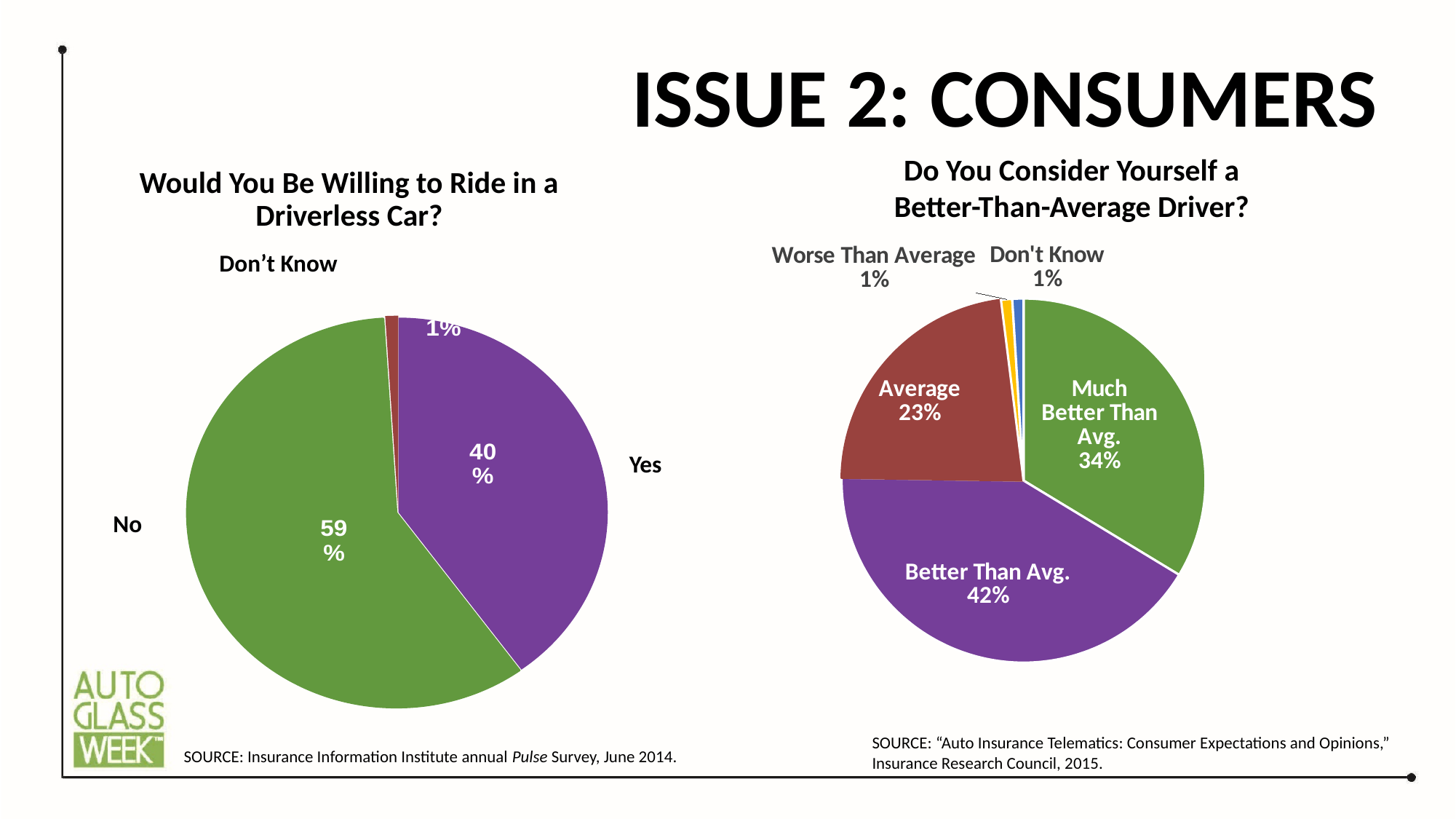
In the 'Would You Be Willing to Ride in a Driverless Car?' chart, which response has the largest share? No In the 'Would You Be Willing to Ride in a Driverless Car?' chart, what is the difference between the No and Yes shares? 19% In the 'Do You Consider Yourself a Better-Than-Average Driver?' chart, which response has the largest share? Better Than Avg. In the 'Would You Be Willing to Ride in a Driverless Car?' chart, which response has the smallest share? Don't Know In the 'Do You Consider Yourself a Better-Than-Average Driver?' chart, which is larger: Much Better Than Avg. or Average? Much Better Than Avg. In the 'Do You Consider Yourself a Better-Than-Average Driver?' chart, how many categories are shown? 5 In the 'Do You Consider Yourself a Better-Than-Average Driver?' chart, what percentage answered Average? 23% What type of chart is used for 'Would You Be Willing to Ride in a Driverless Car?' Pie chart In the 'Do You Consider Yourself a Better-Than-Average Driver?' chart, what percentage answered Better Than Avg.? 42% In the 'Do You Consider Yourself a Better-Than-Average Driver?' chart, what is the difference between Better Than Avg. and Much Better Than Avg.? 8% In the 'Would You Be Willing to Ride in a Driverless Car?' chart, what percentage answered Yes? 40% In the 'Would You Be Willing to Ride in a Driverless Car?' chart, what percentage answered No? 59%